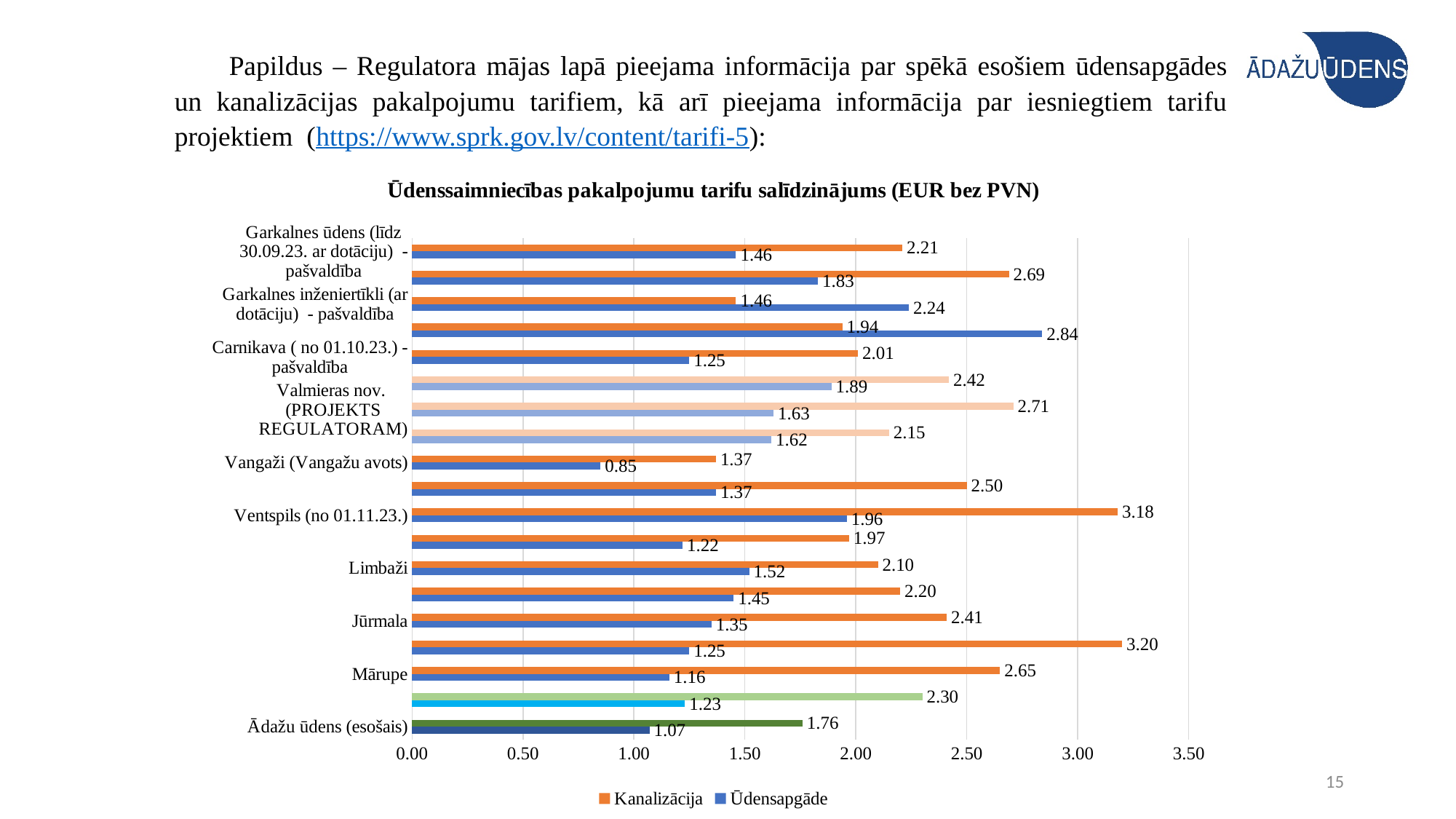
What is the Ūdensapgāde value for Vangaži (Vangažu avots)? 0.85 How many series does the legend list? 2 What is the Kanalizācija value for Ādažu ūdens (esošais)? 1.76 What is the Kanalizācija value for Mārupe? 2.65 Which has the larger Kanalizācija value, Ventspils (no 01.11.23.) or Mārupe? Ventspils (no 01.11.23.) What is the title of the chart? Ūdenssaimniecības pakalpojumu tarifu salīdzinājums (EUR bez PVN) What is the difference between the Kanalizācija and Ūdensapgāde values for Ādažu ūdens (esošais)? 0.69 What are the two series named in the legend? Kanalizācija and Ūdensapgāde What is the Ūdensapgāde value for Ādažu ūdens (esošais)? 1.07 What type of chart is shown on the slide? Bar chart Is the Kanalizācija value for Jūrmala greater or less than 2.00? greater What is the Kanalizācija value for Ventspils (no 01.11.23.)? 3.18